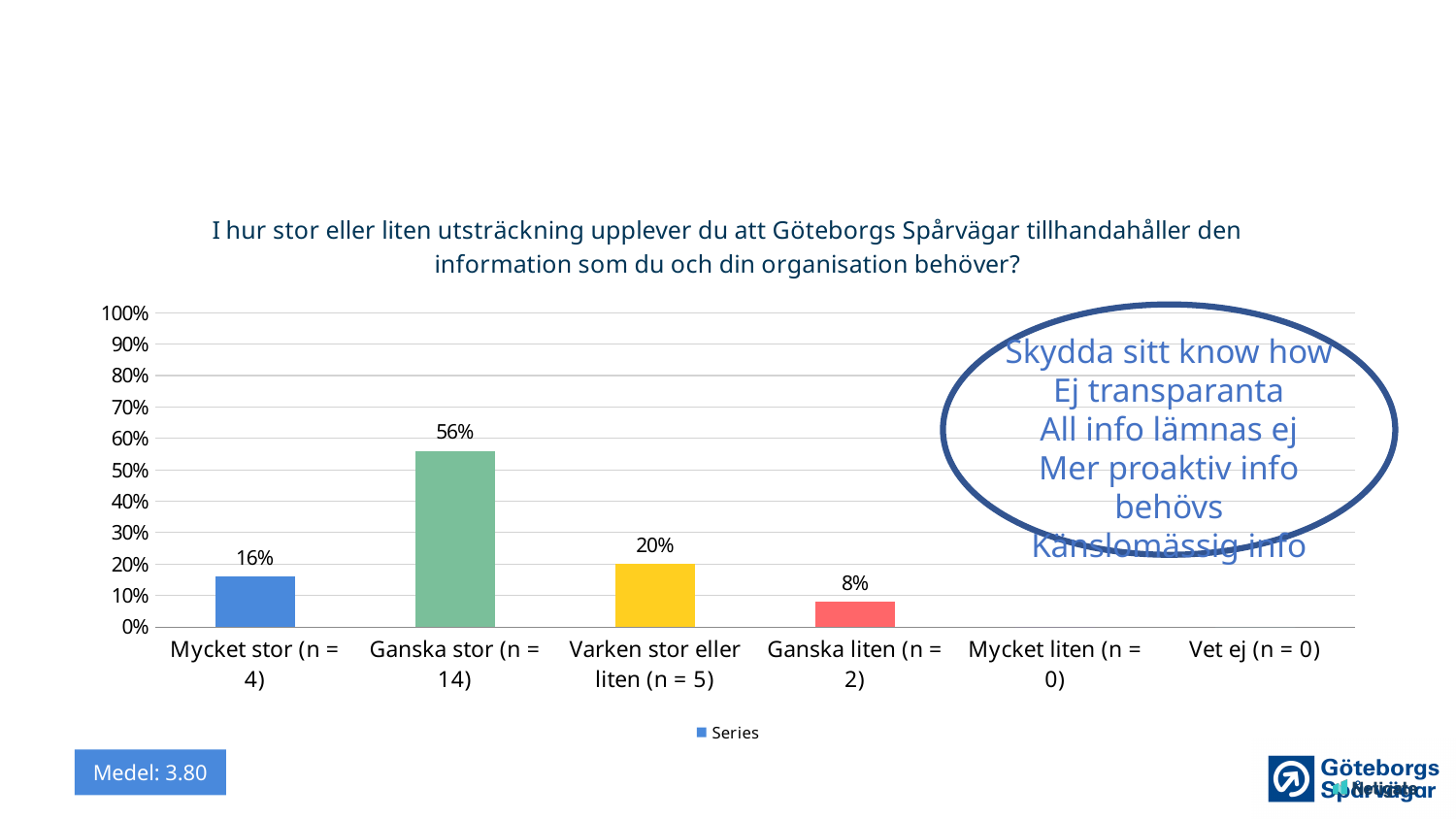
What is the value for "Ganska stor (n = 14)"? 56% What is the legend entry shown below the chart? Series What is the value for "Mycket stor (n = 4)"? 16% Is the value for "Ganska stor (n = 14)" greater or less than 50%? greater What is the value for "Ganska liten (n = 2)"? 8% Which category with a visible bar has the lowest value? Ganska liten (n = 2) What kind of chart is shown on the slide? bar chart What is the difference between the values for "Ganska stor (n = 14)" and "Varken stor eller liten (n = 5)"? 36% Which category has the highest value? Ganska stor (n = 14) What is the value for "Varken stor eller liten (n = 5)"? 20% How many categories are shown on the x axis? 6 Which is larger, the value for "Mycket stor (n = 4)" or the value for "Varken stor eller liten (n = 5)"? Varken stor eller liten (n = 5)